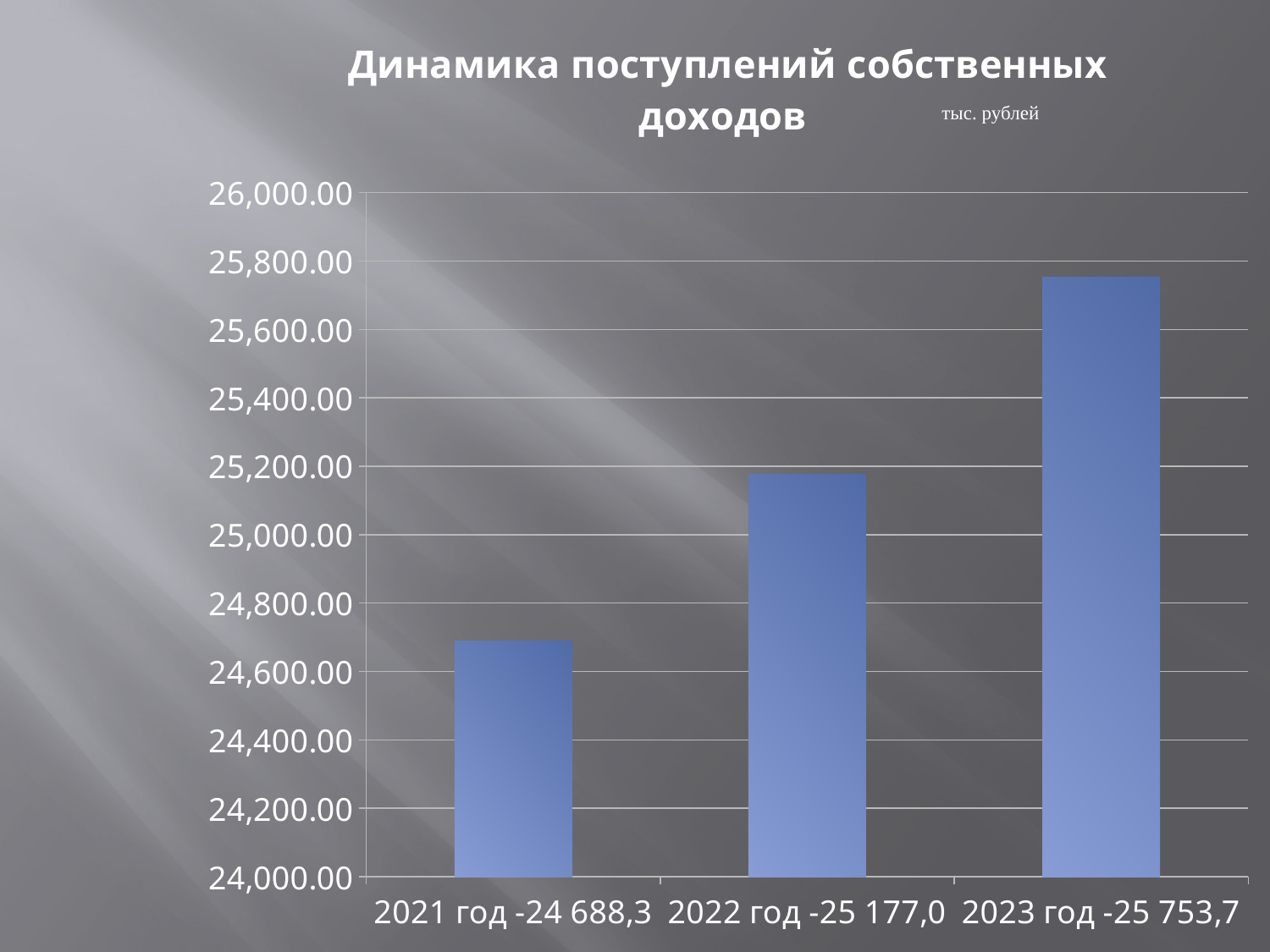
What is the value of own revenues for 2021 год, as printed on the slide? 24 688,3 What is the value of own revenues for 2023 год, as printed on the slide? 25 753,7 What type of chart is shown on the slide? bar chart What is the difference between the values for 2022 год and 2021 год? 488,7 What is the value of own revenues for 2022 год, as printed on the slide? 25 177,0 What is the title of the chart? Динамика поступлений собственных доходов Do the values rise or fall from 2021 год to 2023 год? rise How many bars (years) are shown on the chart? 3 Which year has the lowest value of own revenues? 2021 год In what units are the values on the chart expressed, according to the slide? тыс. рублей What is the difference between the values for 2023 год and 2022 год? 576,7 Which year has the highest value of own revenues? 2023 год